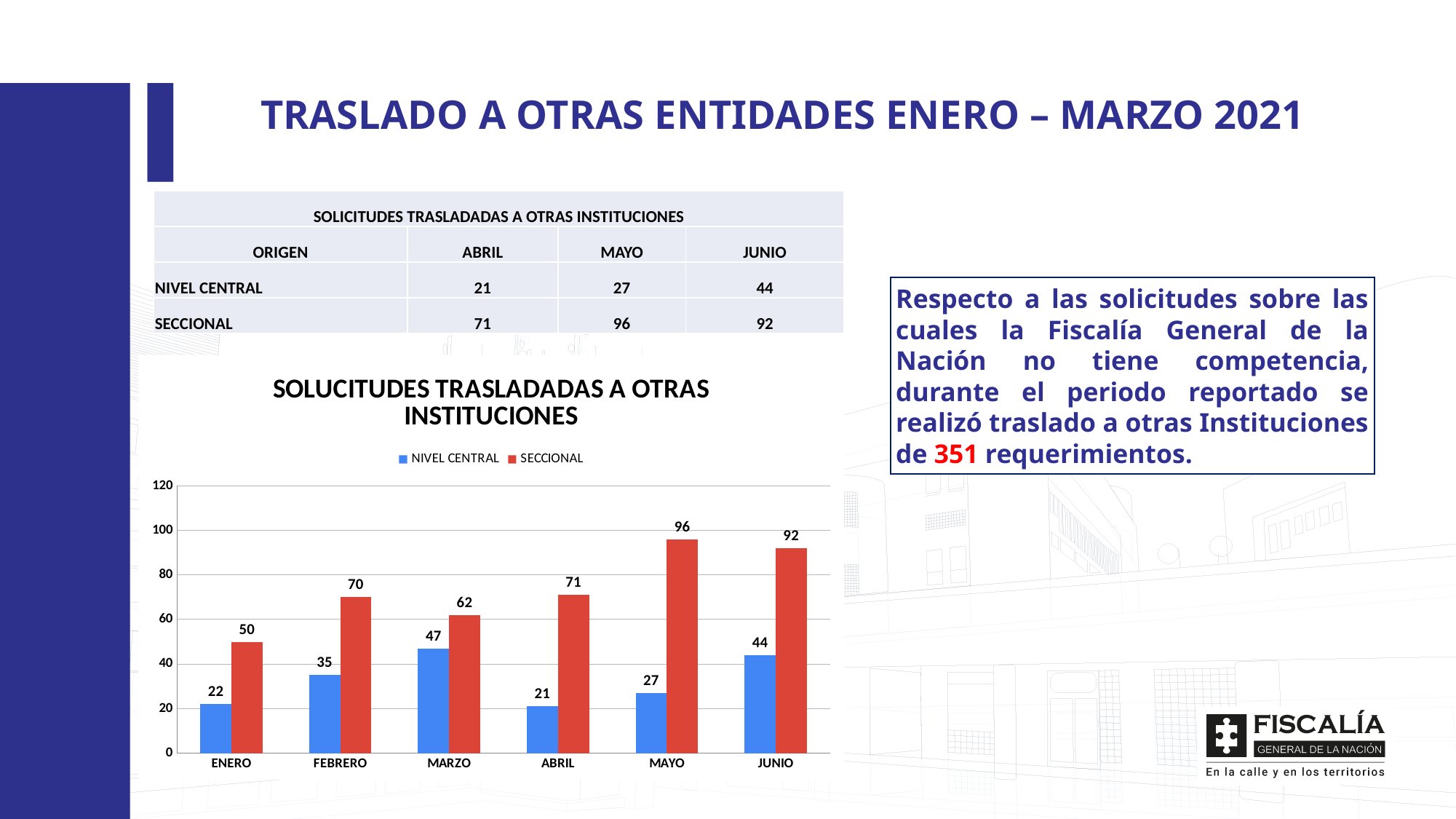
What is the difference between the SECCIONAL and NIVEL CENTRAL values in JUNIO? 48 What is the value for SECCIONAL in MAYO? 96 What kind of chart is shown on the slide? Bar chart What colour are the SECCIONAL bars in the chart? Red What is the value for SECCIONAL in ENERO? 50 In which month is the NIVEL CENTRAL value lowest? ABRIL Which is larger: NIVEL CENTRAL in FEBRERO or NIVEL CENTRAL in JUNIO? NIVEL CENTRAL in JUNIO How many months are shown on the x axis of the chart? 6 What is the value for NIVEL CENTRAL in MARZO? 47 Is the value for SECCIONAL in ABRIL greater or less than 60? greater How many series does the chart legend list? 2 In which month is the SECCIONAL value highest? MAYO